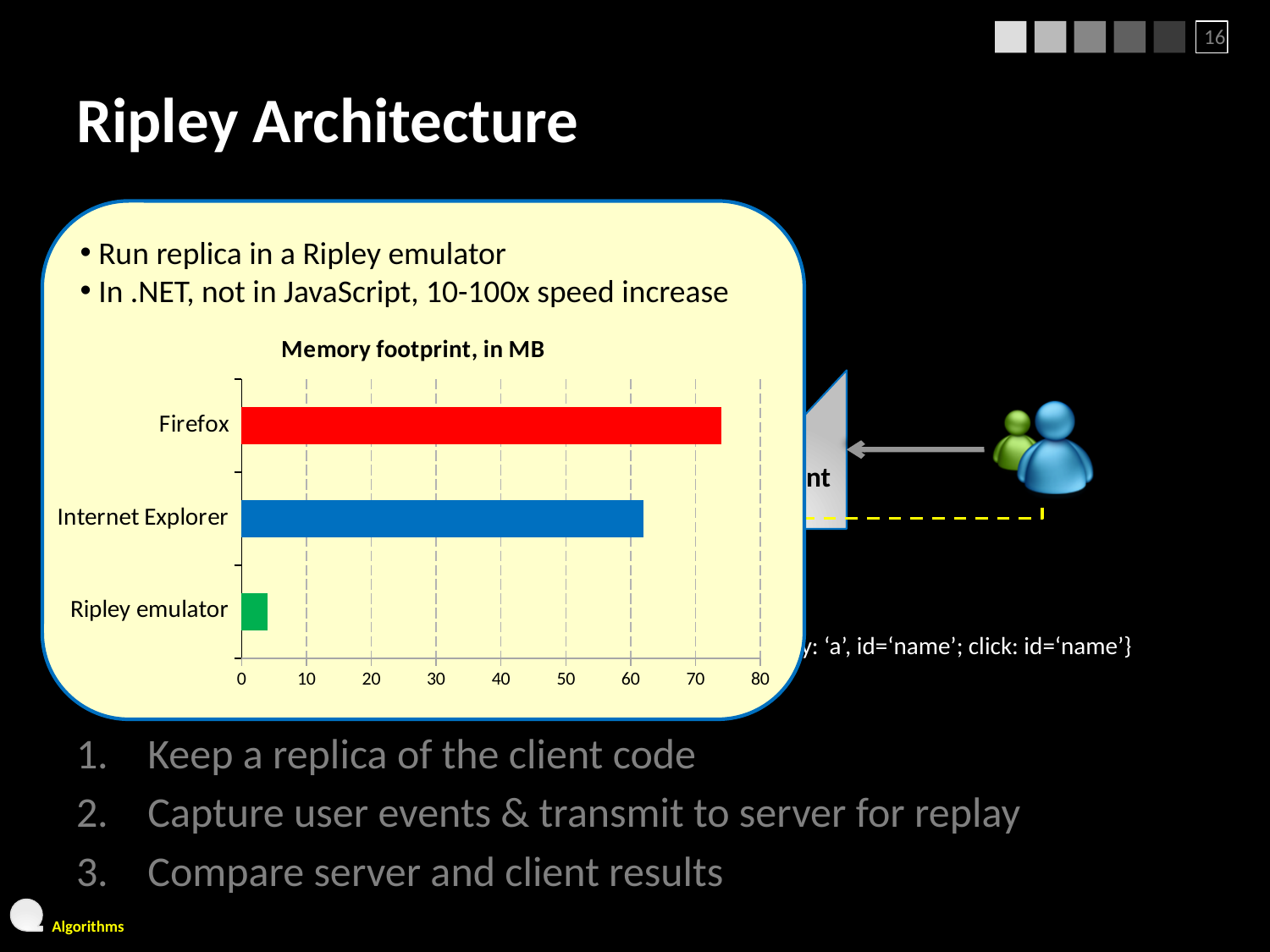
How many categories are plotted in the chart? 3 Is the value for Firefox greater or less than 70? greater What colour is the bar for Internet Explorer? blue Which has a larger memory footprint, Internet Explorer or Ripley emulator? Internet Explorer Which has a larger memory footprint, Firefox or Internet Explorer? Firefox Is the value for Internet Explorer greater or less than 70? less Is the value for Internet Explorer greater or less than 60? greater What is the title of the chart? Memory footprint, in MB Which category has the lowest memory footprint? Ripley emulator What kind of chart is shown on the slide? bar chart Which category has the highest memory footprint? Firefox